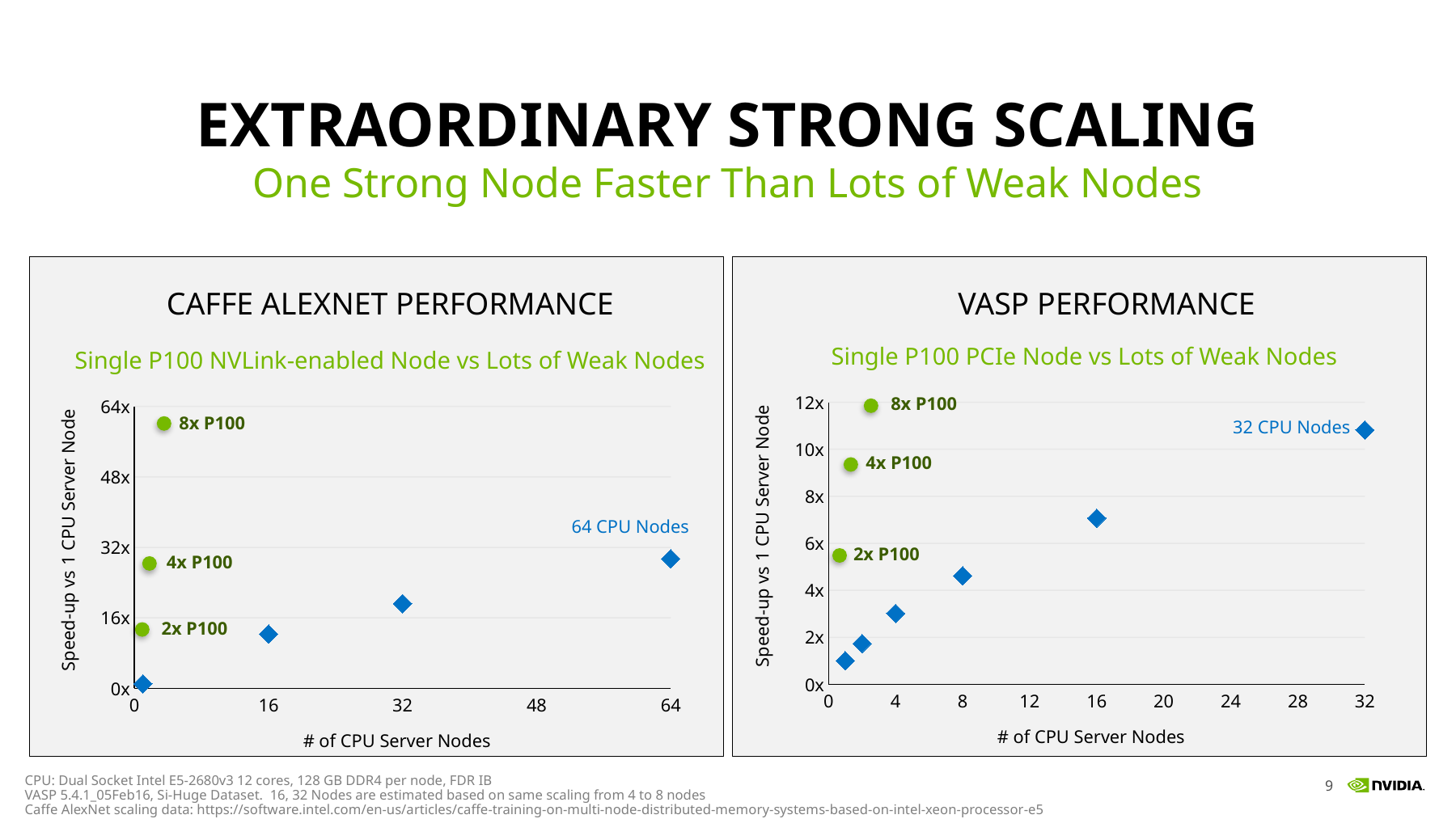
In the CAFFE ALEXNET PERFORMANCE chart, how many blue CPU-node data points are plotted? 4 In the VASP PERFORMANCE chart, how many blue CPU-node data points are plotted? 6 In the VASP PERFORMANCE chart, is the speed-up for 32 CPU Nodes greater or less than 10x? greater What is the subtitle shown under the CAFFE ALEXNET PERFORMANCE chart title? Single P100 NVLink-enabled Node vs Lots of Weak Nodes In the CAFFE ALEXNET PERFORMANCE chart, is the speed-up for 8x P100 greater or less than 48x? greater What kind of chart is the CAFFE ALEXNET PERFORMANCE chart? scatter chart In the CAFFE ALEXNET PERFORMANCE chart, do the CPU-node speed-ups rise or fall as the number of CPU server nodes increases? rise In the CAFFE ALEXNET PERFORMANCE chart, is the speed-up for 64 CPU Nodes greater or less than 32x? less In the VASP PERFORMANCE chart, which has the higher speed-up: 8x P100 or 32 CPU Nodes? 8x P100 What is the y-axis label of the VASP PERFORMANCE chart? Speed-up vs 1 CPU Server Node